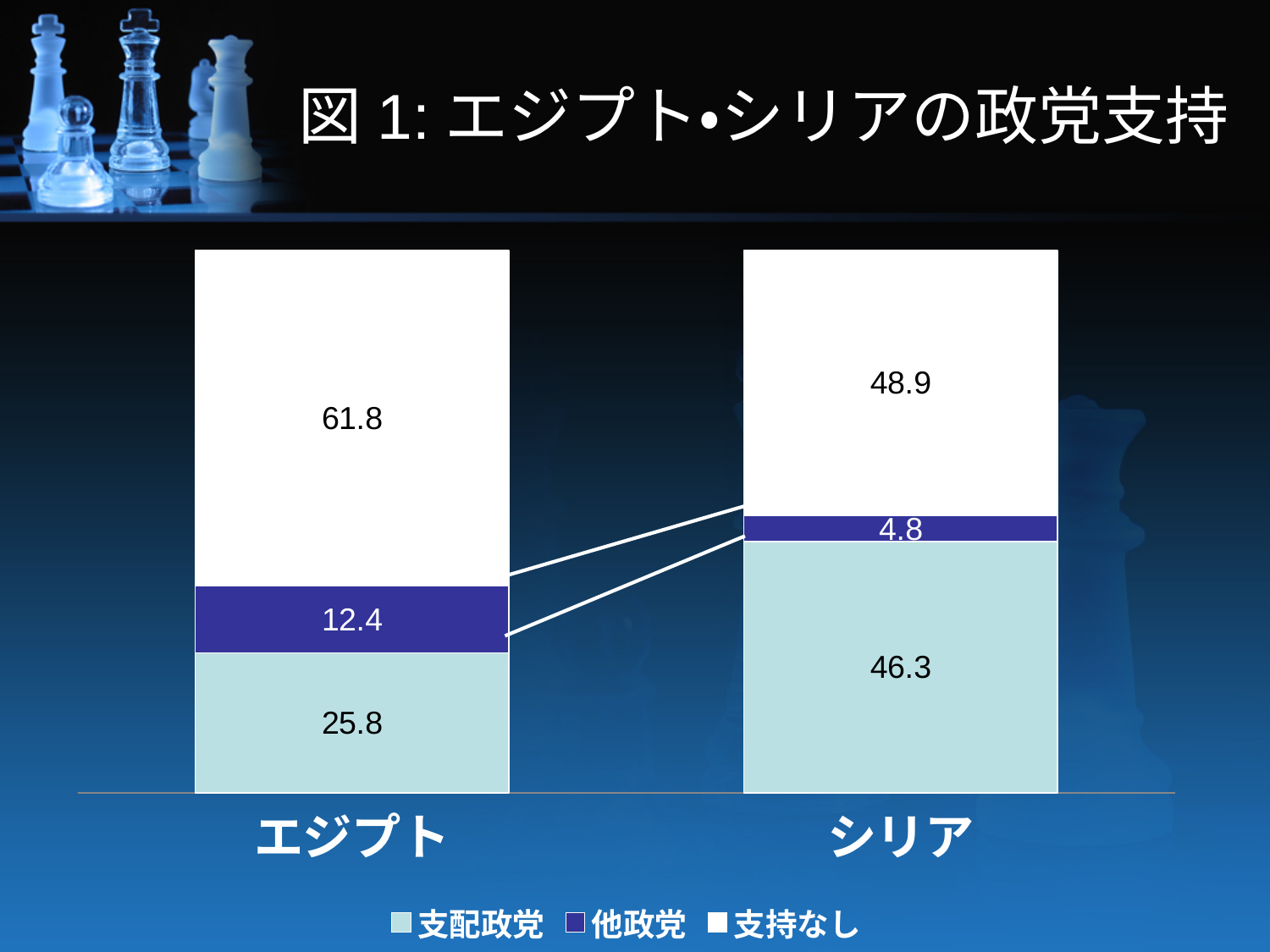
How many categories are shown on the x axis? 2 What is the value for 支持なし in エジプト? 61.8 Which category has the higher value for 支持なし, エジプト or シリア? エジプト What is the difference between the 支配政党 values for シリア and エジプト? 20.5 What is the value for 支配政党 in エジプト? 25.8 How many series does the legend list? 3 What is the difference between the 他政党 values for エジプト and シリア? 7.6 Which category has the higher value for 支配政党, エジプト or シリア? シリア What is the value for 支配政党 in シリア? 46.3 What is the value for 他政党 in シリア? 4.8 What kind of chart is shown on the slide? Stacked bar chart What is the total of the stacked bar for エジプト? 100